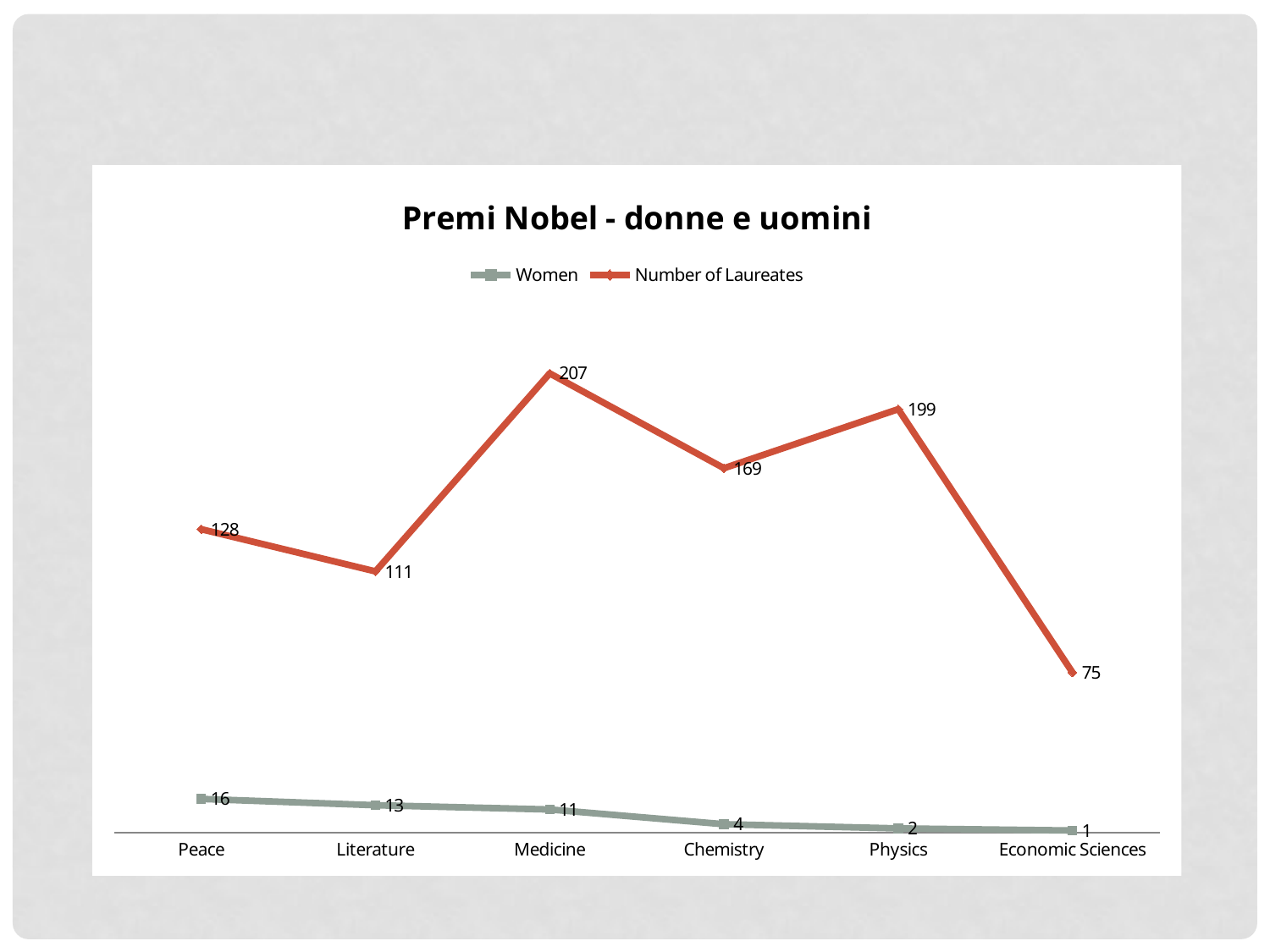
Which category has the highest Number of Laureates? Medicine What is the difference between the Number of Laureates for Physics and for Chemistry? 30 What is the Number of Laureates value for Medicine? 207 What is the Number of Laureates value for Economic Sciences? 75 Do the Women values rise or fall from Peace to Economic Sciences? Fall How many series does the legend list? 2 How many categories are shown on the x axis? 6 What is the title of the chart? Premi Nobel - donne e uomini What kind of chart is shown on the slide? Line chart Which category has the lowest Women value? Economic Sciences Which is larger, the Number of Laureates for Peace or for Literature? Peace What is the Women value for Peace? 16